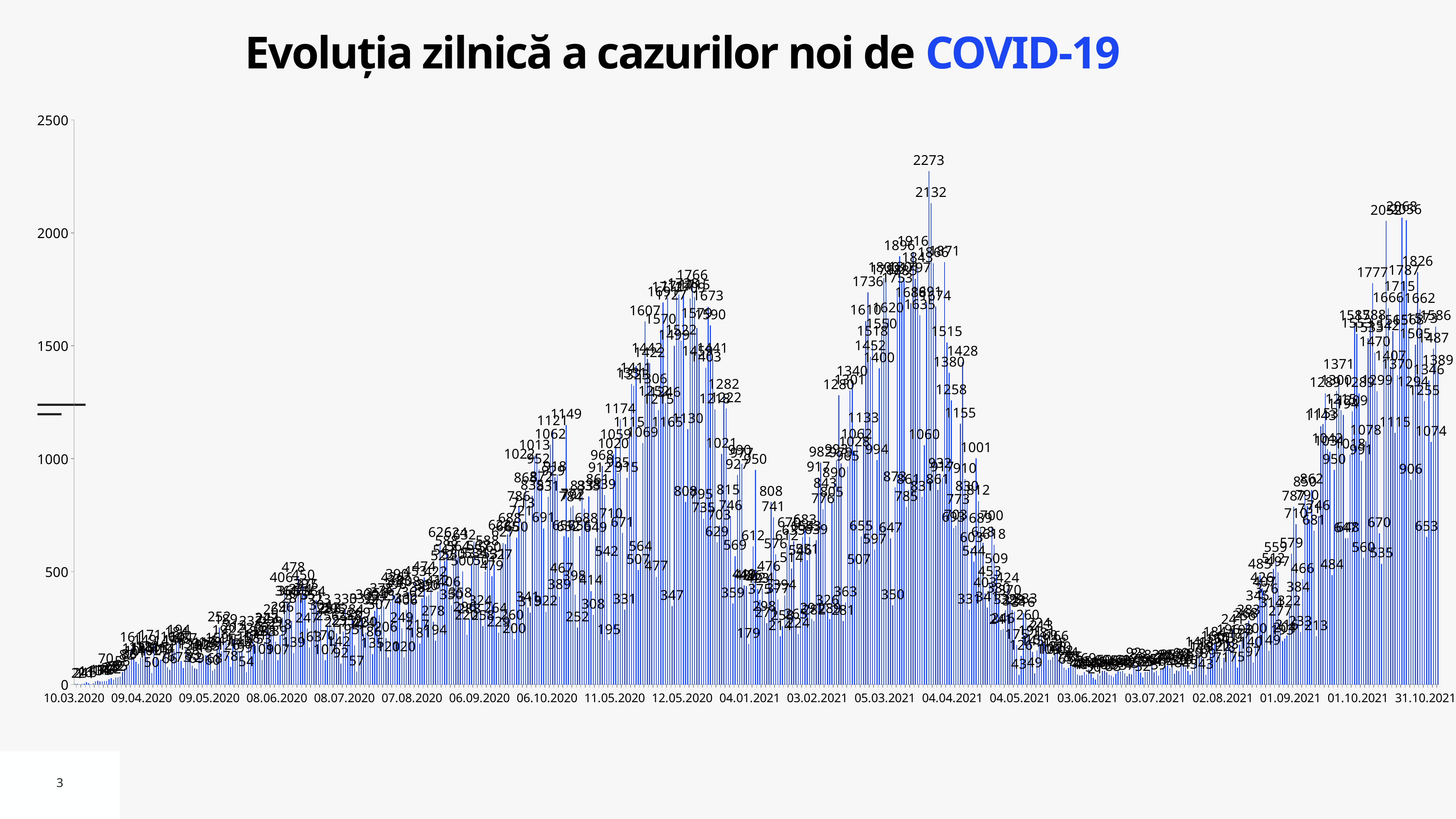
Do the values rise or fall between 03.06.2021 and 31.10.2021? rise What is the first date label on the x axis? 10.03.2020 Do the values rise or fall between 04.04.2021 and 03.06.2021? fall What is the difference between the two highest labelled values, 2273 and 2132? 141 What is the highest daily value labelled on the chart? 2273 What is the maximum value shown on the y axis? 2500 Is the value for the first day, 10.03.2020, greater or less than 500? less Which is larger, the peak value 2273 or the value 2132 next to it? 2273 What is the title of the chart? Evoluția zilnică a cazurilor noi de COVID-19 What kind of chart is shown on the slide? bar chart Is the highest value on the chart greater or less than 2000? greater What is the last date label on the x axis? 31.10.2021